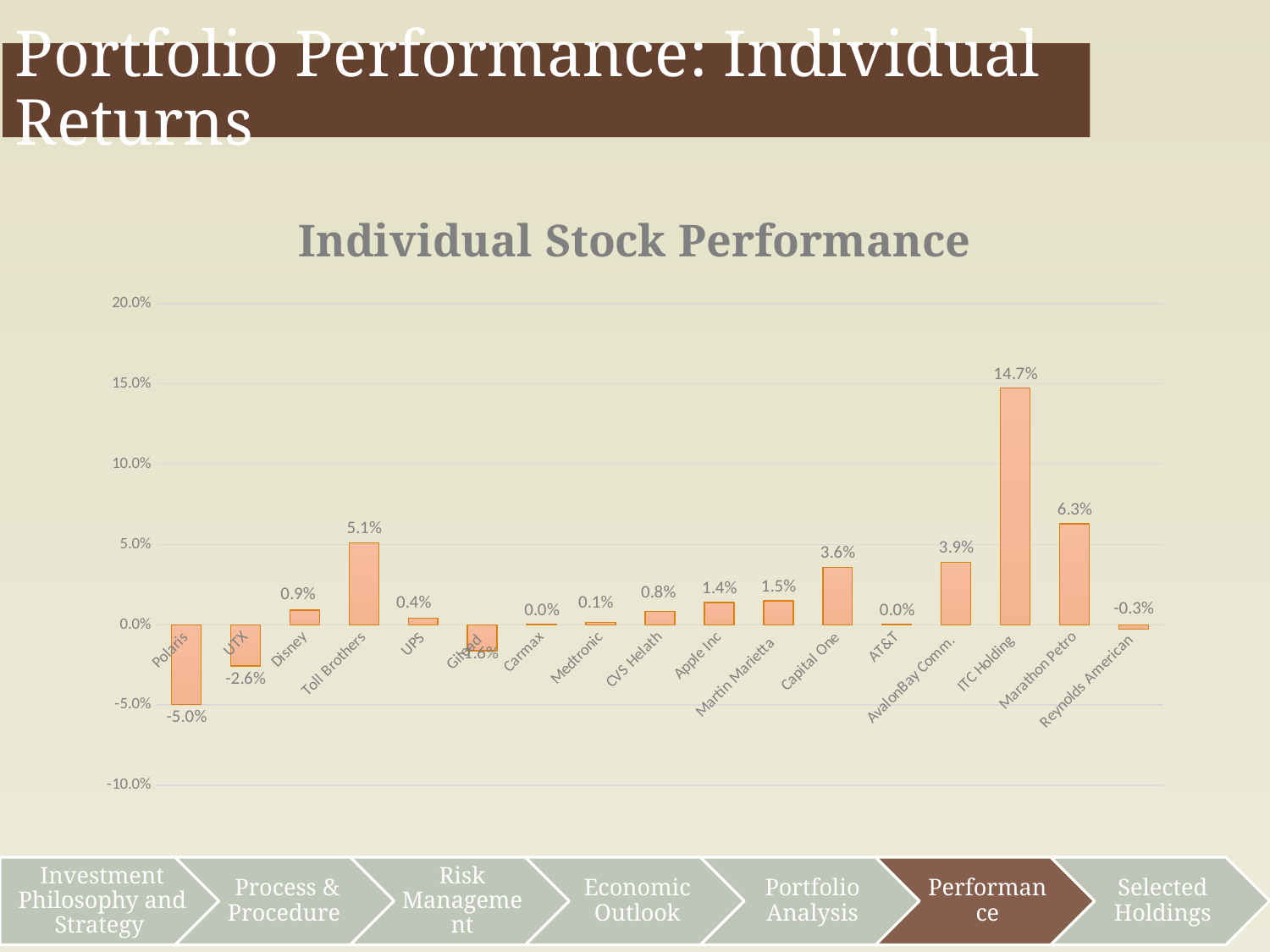
What is the value for Capital One in the Individual Stock Performance chart? 3.6% How many stocks are shown in the Individual Stock Performance chart? 17 Is the value for ITC Holding greater or less than 10.0%? greater Which stock has the highest value in the Individual Stock Performance chart? ITC Holding What kind of chart is the Individual Stock Performance chart? Bar chart What is the value for Polaris in the Individual Stock Performance chart? -5.0% What is the value for Toll Brothers in the Individual Stock Performance chart? 5.1% What is the value for ITC Holding in the Individual Stock Performance chart? 14.7% Which is larger, the value for AvalonBay Comm. or the value for Capital One? AvalonBay Comm. What is the value for Reynolds American in the Individual Stock Performance chart? -0.3% What is the difference between the values for ITC Holding and Marathon Petro? 8.4 percentage points Which stock has the lowest value in the Individual Stock Performance chart? Polaris